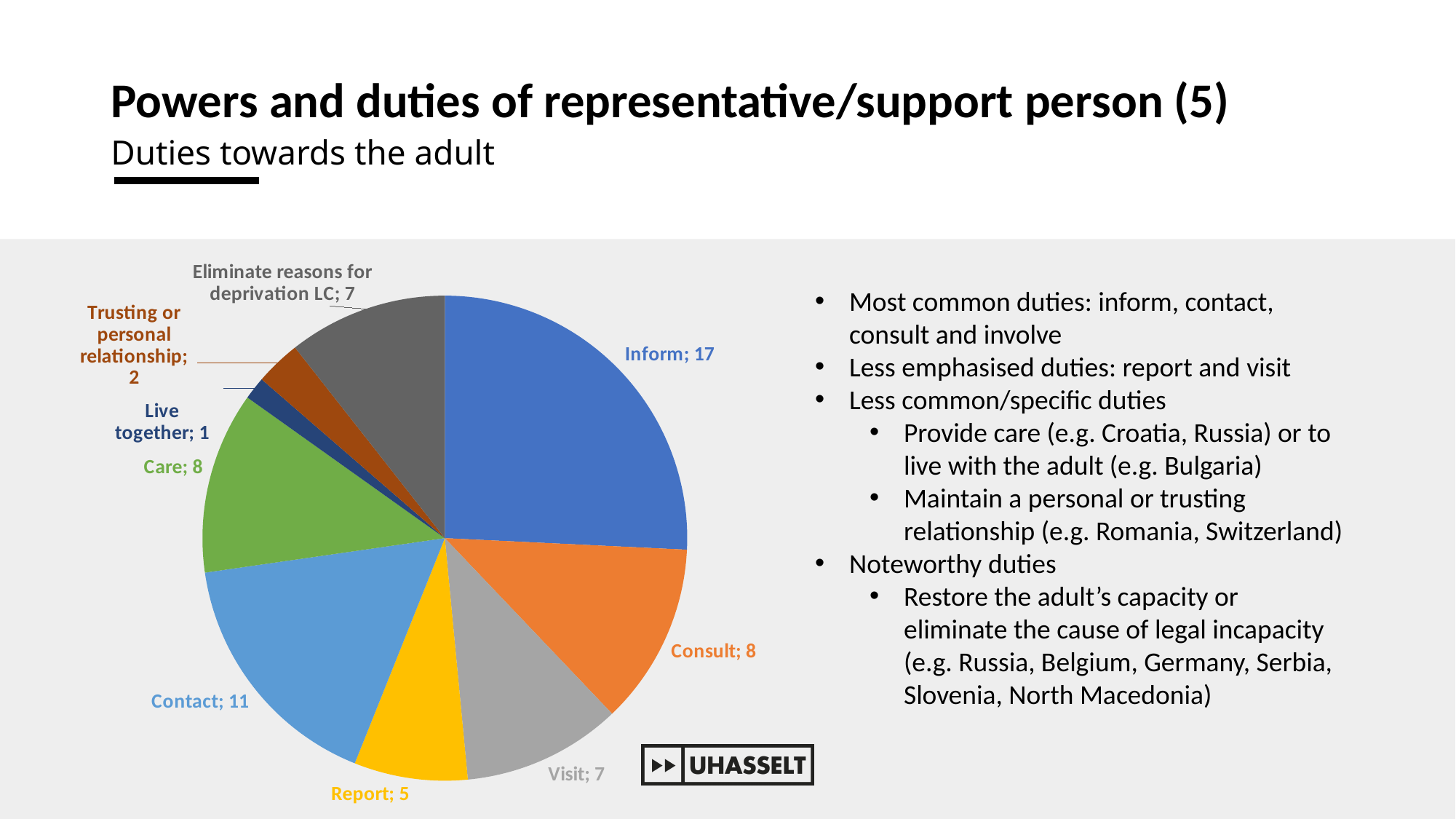
What is the value for Trusting or personal relationship? 2 Do Consult and Care have the same value in the pie chart? Yes, both are 8 What is the total of all the values shown in the pie chart? 66 Which is larger, the value for Contact or the value for Care? Contact What is the difference between the values for Inform and Contact? 6 What is the value for Report in the pie chart? 5 What type of chart is shown on the slide? Pie chart How many slices does the pie chart have? 9 Which duty has the largest slice in the pie chart? Inform What is the value for Contact in the pie chart? 11 What is the value for Eliminate reasons for deprivation LC? 7 Which duty has the smallest slice in the pie chart? Live together